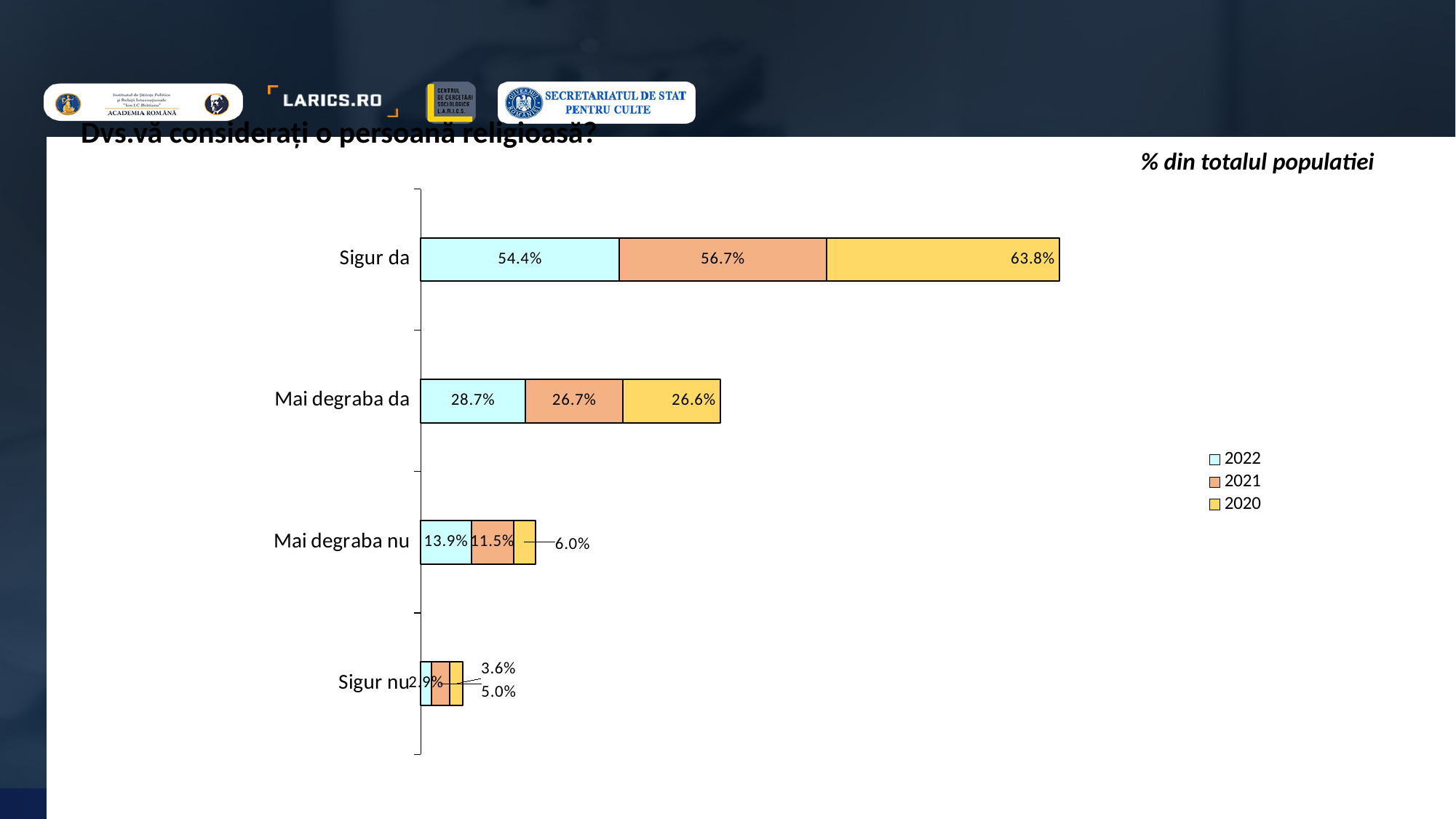
What is the value for 'Mai degraba nu' in 2021? 11.5% What is the value for 'Sigur da' in 2020? 63.8% What kind of chart is shown on the slide? Bar chart What is the value for 'Sigur da' in 2022? 54.4% What is the difference between the 2022 and 2020 values for 'Mai degraba nu'? 7.9 percentage points How many response categories are shown on the chart? 4 What is the difference between the 2020 and 2022 values for 'Sigur da'? 9.4 percentage points Which category has the lowest value for 2022? Sigur nu For 'Mai degraba da', which year has the larger value, 2022 or 2021? 2022 How many series does the legend list? 3 Which category has the highest value for 2020? Sigur da What is the value for 'Mai degraba da' in 2022? 28.7%